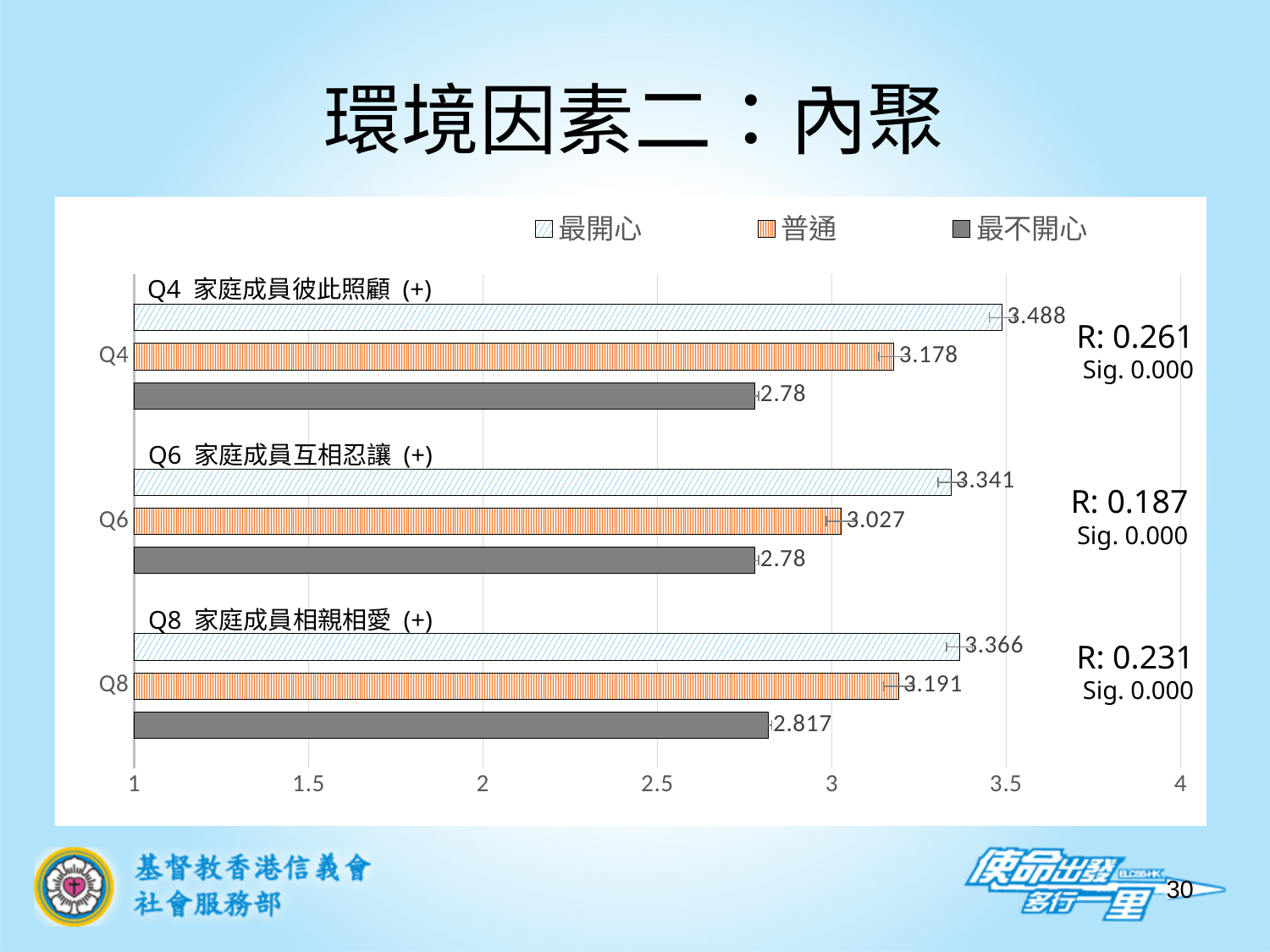
Which category has the lowest 普通 value? Q6 How many series does the legend list? 3 What is the value of 普通 for Q6? 3.027 What is the difference between the 最開心 and 最不開心 values for Q4? 0.708 What kind of chart is shown on the slide? bar chart Is the 最不開心 value for Q6 greater or less than 3? less What is the value of 最開心 for Q4? 3.488 Which category has the highest 最開心 value? Q4 What is the R value shown next to Q6? 0.187 Which is larger, the 普通 value for Q8 or the 普通 value for Q4? Q8 How many categories are shown on the chart? 3 What is the value of 最不開心 for Q8? 2.817